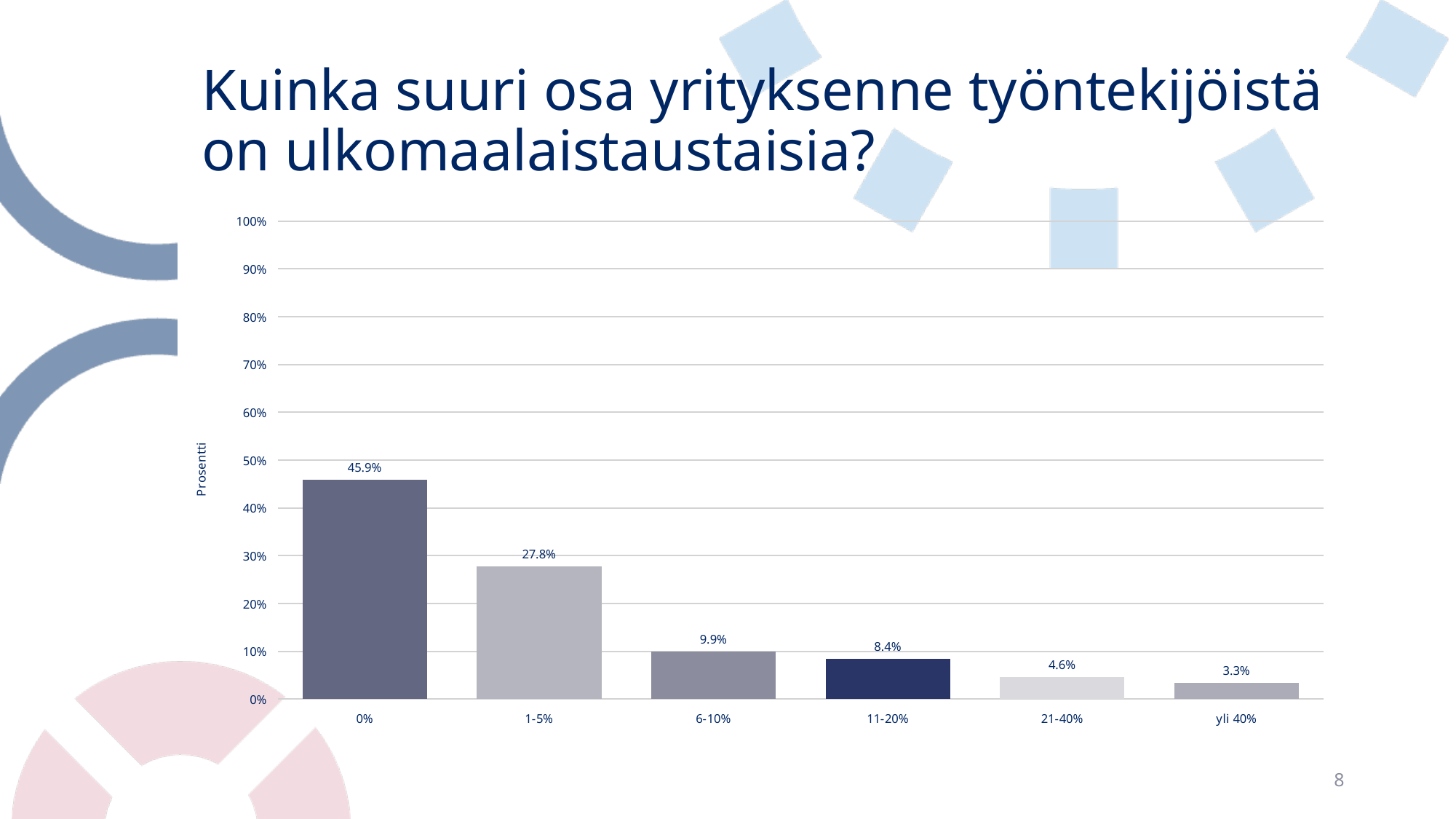
What is the value for the yli 40% category? 3.3% Which is larger, the value for 6-10% or the value for 11-20%? 6-10% What kind of chart is shown on the slide? bar chart Is the value for 1-5% greater or less than 30%? less What is the label of the y axis? Prosentti What is the difference between the values for 0% and 1-5%? 18.1% What is the value for the 1-5% category? 27.8% What is the value for the 0% category? 45.9% How many categories are shown on the x axis? 6 Which category has the lowest value? yli 40% Do the values rise or fall from left to right along the x axis? fall Which category has the highest value? 0%